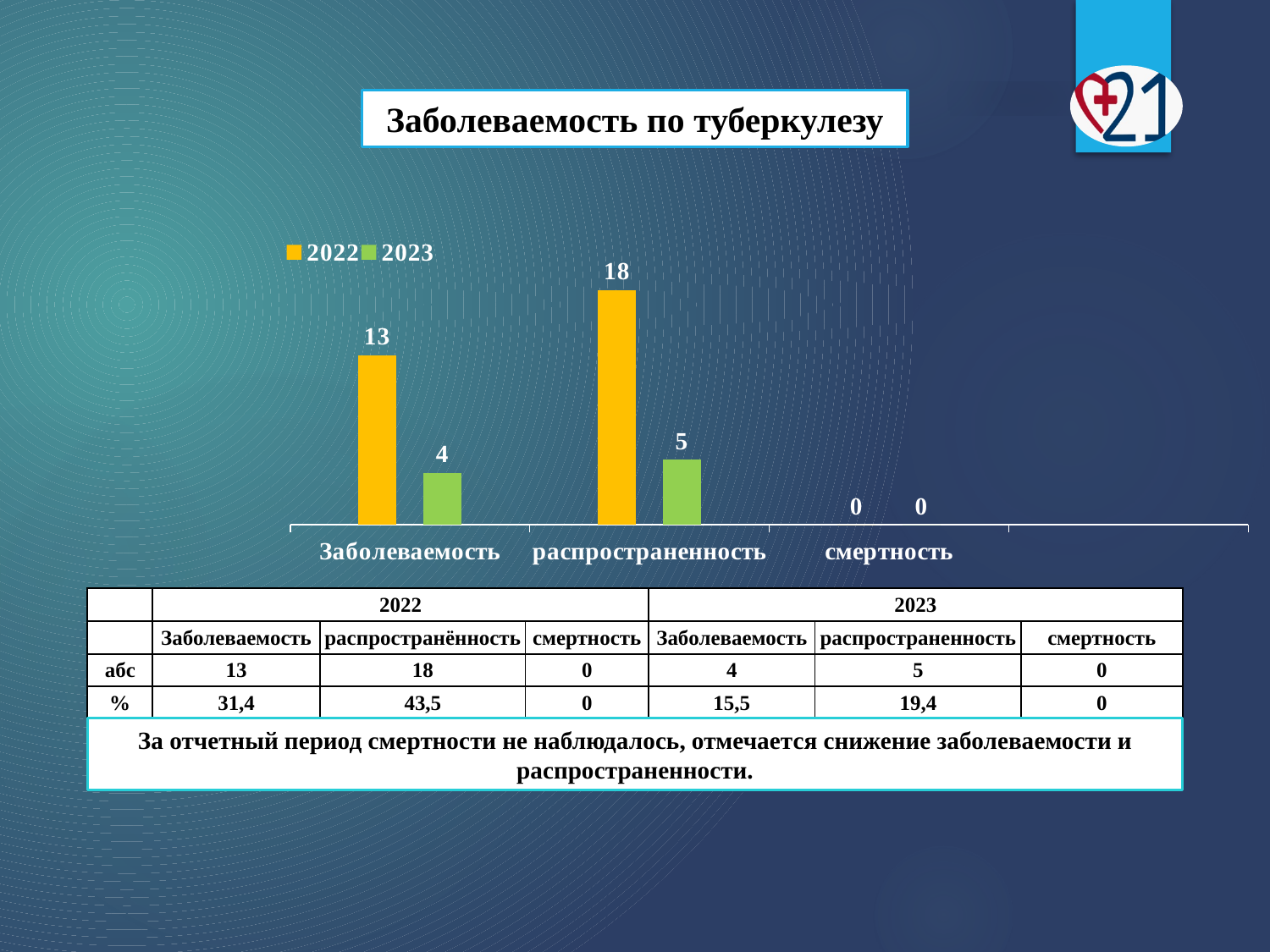
Which category has the lowest value in the 2023 series? смертность How many series does the chart legend list? 2 What is the difference between the 2022 and 2023 values for Заболеваемость? 9 Which category has the highest value in the 2022 series? распространенность What is the difference between the 2022 and 2023 values for распространенность? 13 What is the value for смертность in the 2022 series? 0 What kind of chart is shown on the slide? bar chart What is the value for Заболеваемость in the 2023 series? 4 What is the value for распространенность in the 2023 series? 5 Which is larger: the 2022 value for Заболеваемость or the 2023 value for распространенность? 2022 value for Заболеваемость How many categories are shown on the x axis of the chart? 3 What is the value for Заболеваемость in the 2022 series? 13